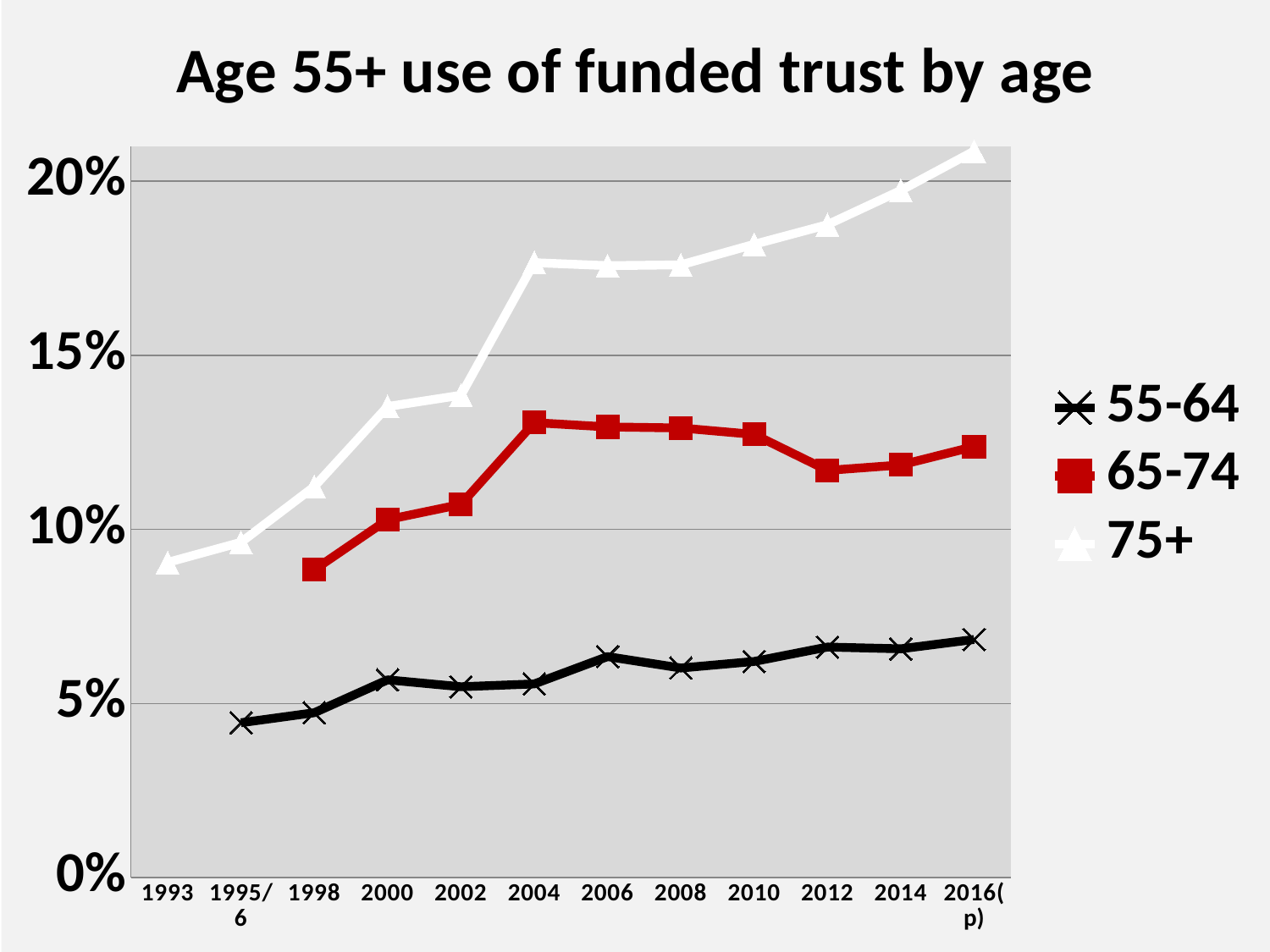
Is the value for 75+ in 2004 greater or less than 15%? greater Which age group has the highest value in 2016(p)? 75+ What is the title of the chart? Age 55+ use of funded trust by age Is the value for 55-64 in 1995/6 greater or less than 5%? less Do the values for 75+ generally rise or fall from 1993 to 2016(p)? rise What kind of chart is shown on the slide? line chart Is the value for 75+ in 2016(p) greater or less than 20%? greater Which age group has the lowest value in 2004? 55-64 How many points are shown along the x axis? 12 How many series does the legend list? 3 Which is larger in 2010, the value for 75+ or the value for 65-74? 75+